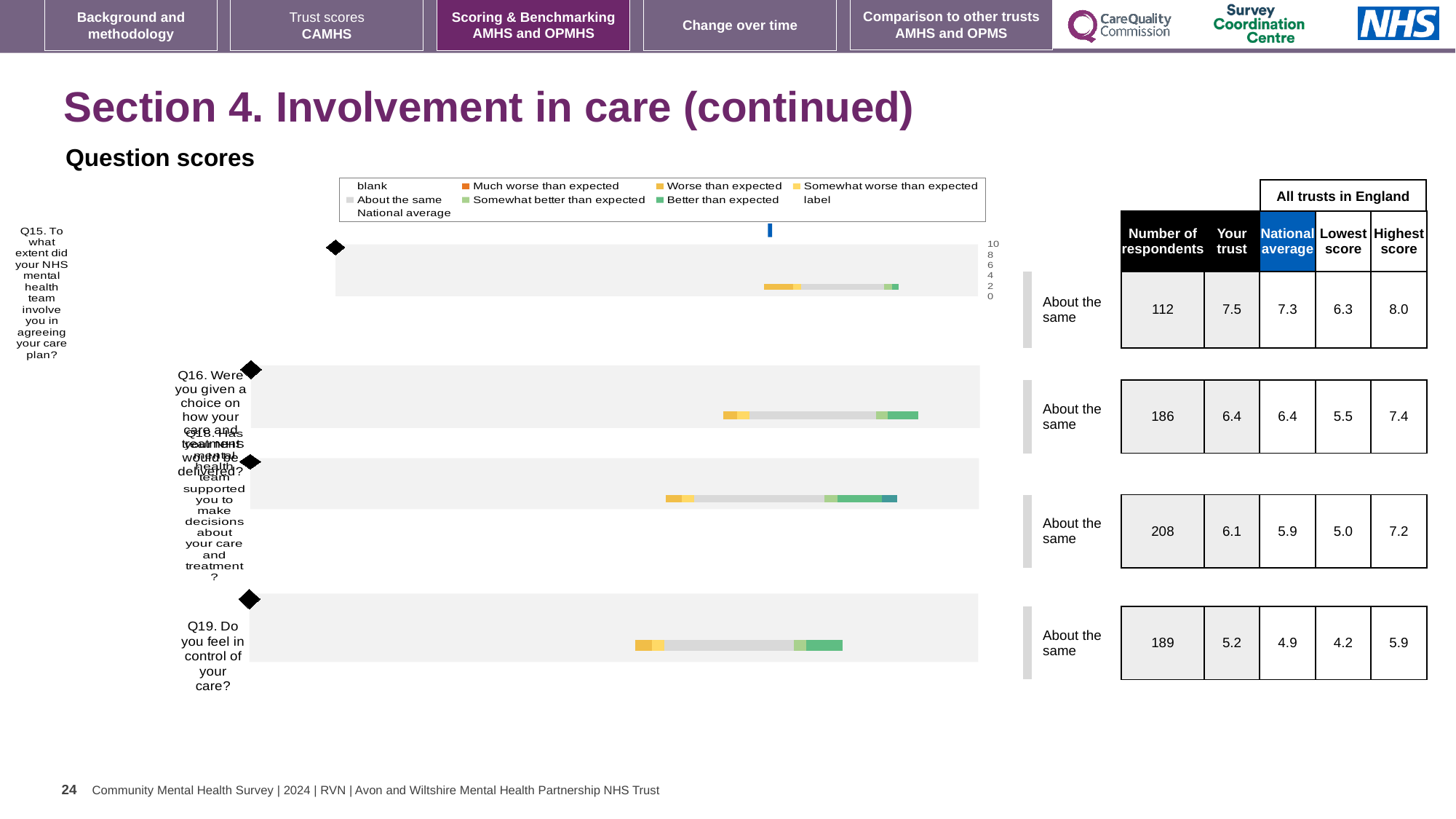
What is the 'Your trust' score for Q15 (involving you in agreeing your care plan)? 7.5 What kind of chart is used to show the question scores on this slide? bar chart What is the national average score for Q19 (Do you feel in control of your care)? 4.9 Which question has the highest 'Your trust' score? Q15 How many respondents answered Q18? 208 How many questions (bars) are plotted in the question scores chart? 4 What is the lowest score across all trusts in England for Q18? 5.0 Which question has the lowest 'Your trust' score? Q19 For Q18, which is larger: the 'Your trust' score or the national average? Your trust What is the difference between the 'Your trust' score and the national average for Q15? 0.2 What is the highest score across all trusts in England for Q16? 7.4 Which question has the largest number of respondents? Q18